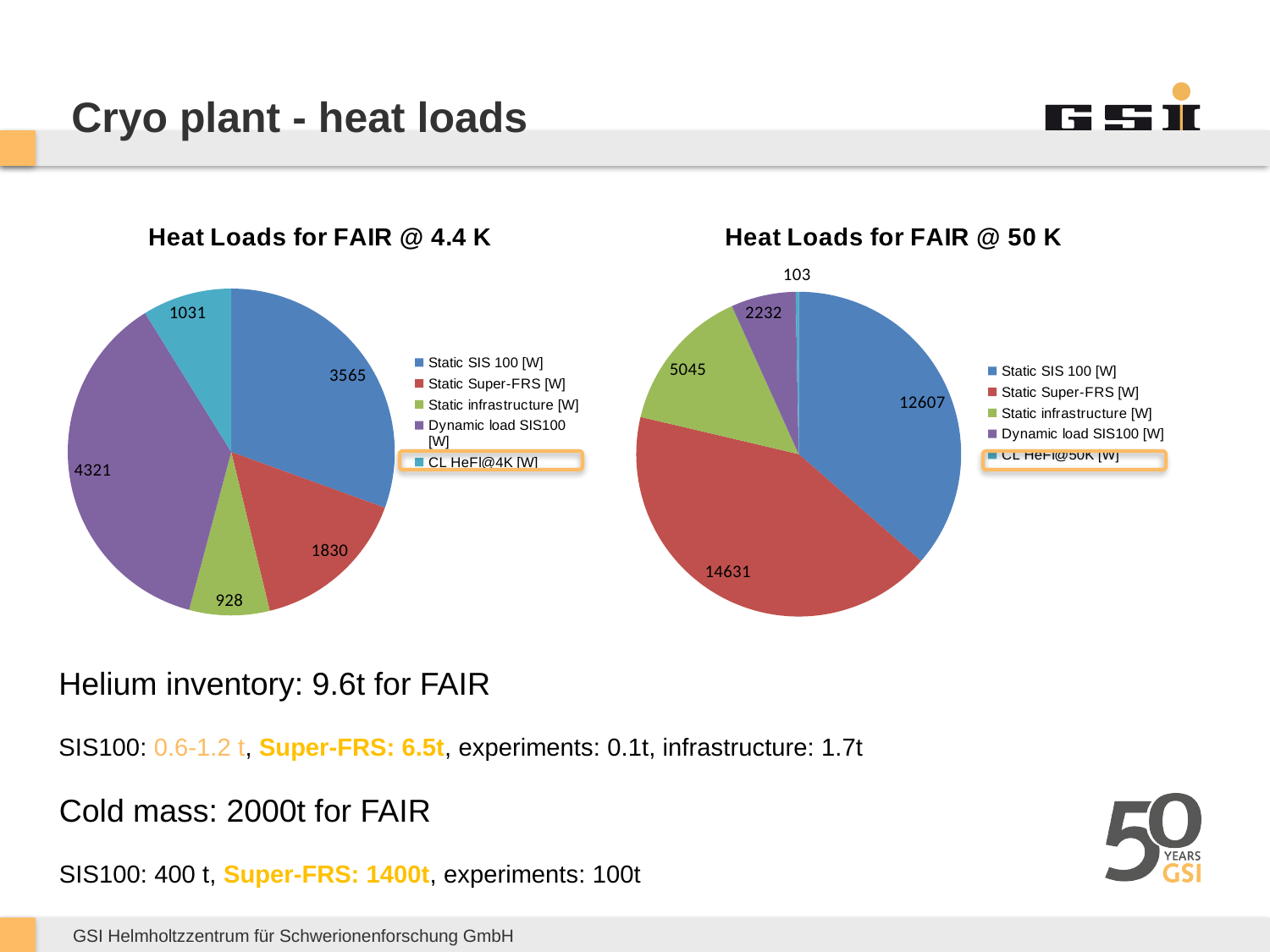
How many slices does the 'Heat Loads for FAIR @ 50 K' chart have? 5 In the 'Heat Loads for FAIR @ 50 K' chart, which category has the smallest value? CL HeFl@50K [W] In the 'Heat Loads for FAIR @ 4.4 K' chart, which category has the smallest value? Static infrastructure [W] In the 'Heat Loads for FAIR @ 4.4 K' chart, which category has the largest value? Dynamic load SIS100 [W] What type of chart is 'Heat Loads for FAIR @ 4.4 K'? Pie chart In the 'Heat Loads for FAIR @ 50 K' chart, what is the value for CL HeFl@50K [W]? 103 In the 'Heat Loads for FAIR @ 50 K' chart, what is the value for Static Super-FRS [W]? 14631 In the 'Heat Loads for FAIR @ 4.4 K' chart, which is larger: Static Super-FRS [W] or CL HeFl@4K [W]? Static Super-FRS [W] What is the total of all slices in the 'Heat Loads for FAIR @ 4.4 K' chart? 11675 In the 'Heat Loads for FAIR @ 4.4 K' chart, what is the value for Static SIS 100 [W]? 3565 In the 'Heat Loads for FAIR @ 4.4 K' chart, what is the value for Dynamic load SIS100 [W]? 4321 In the 'Heat Loads for FAIR @ 50 K' chart, what is the difference between Static Super-FRS [W] and Static SIS 100 [W]? 2024